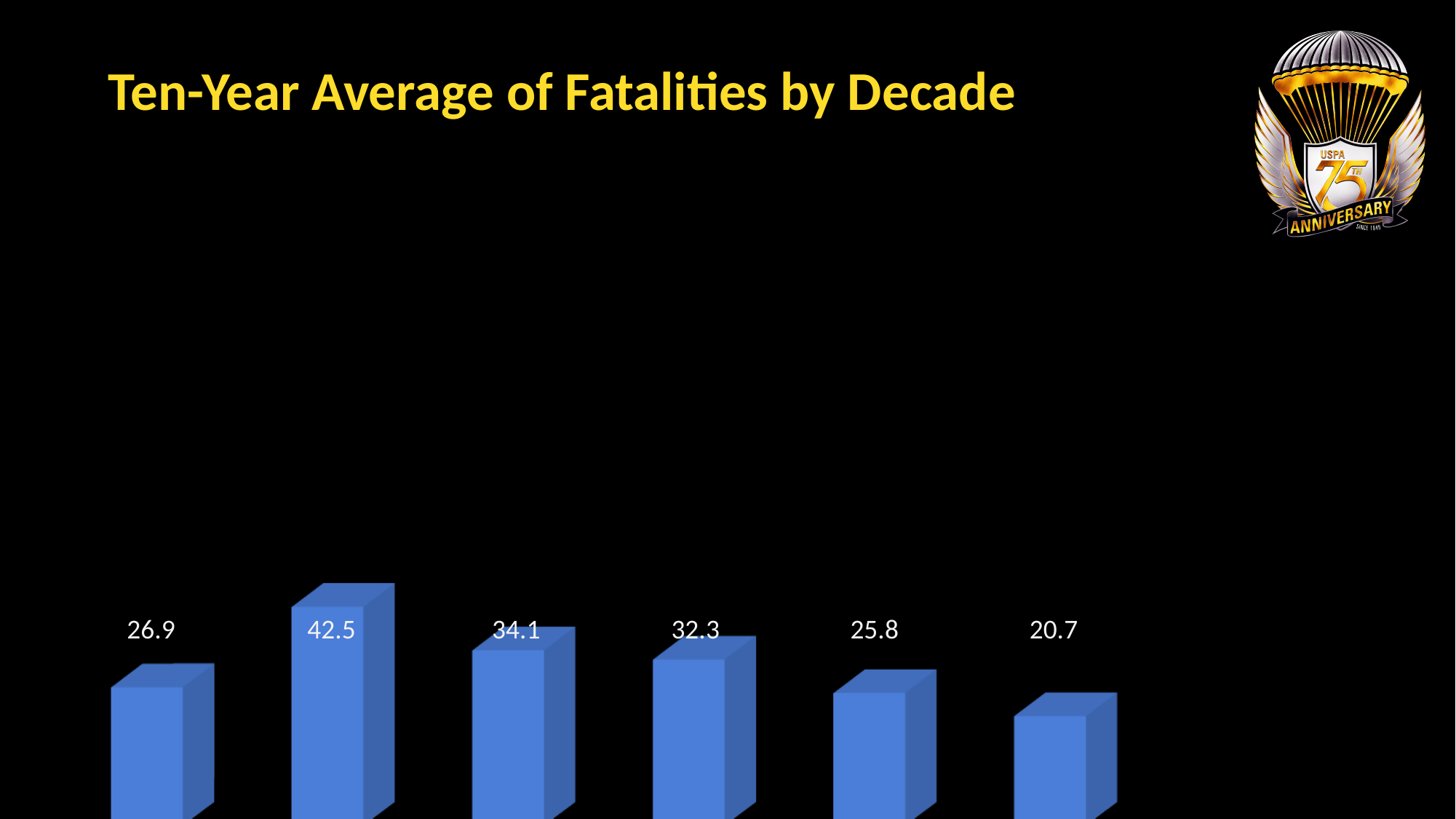
What is the value shown on the rightmost bar? 20.7 What is the difference between the highest value (42.5) and the lowest value (20.7)? 21.8 What is the value shown on the fourth bar from the left? 32.3 How many bars are plotted in the chart? 6 What is the difference between the third bar (34.1) and the fourth bar (32.3)? 1.8 Which bar has the lowest value? The rightmost bar (20.7) What is the value shown on the second bar from the left? 42.5 Which is larger, the value of the leftmost bar or the value of the fifth bar from the left? The leftmost bar (26.9) What is the value shown on the leftmost bar? 26.9 What kind of chart is shown on the slide? Bar chart From the second bar onward, do the values rise or fall moving left to right? Fall Which bar has the highest value? The second bar from the left (42.5)